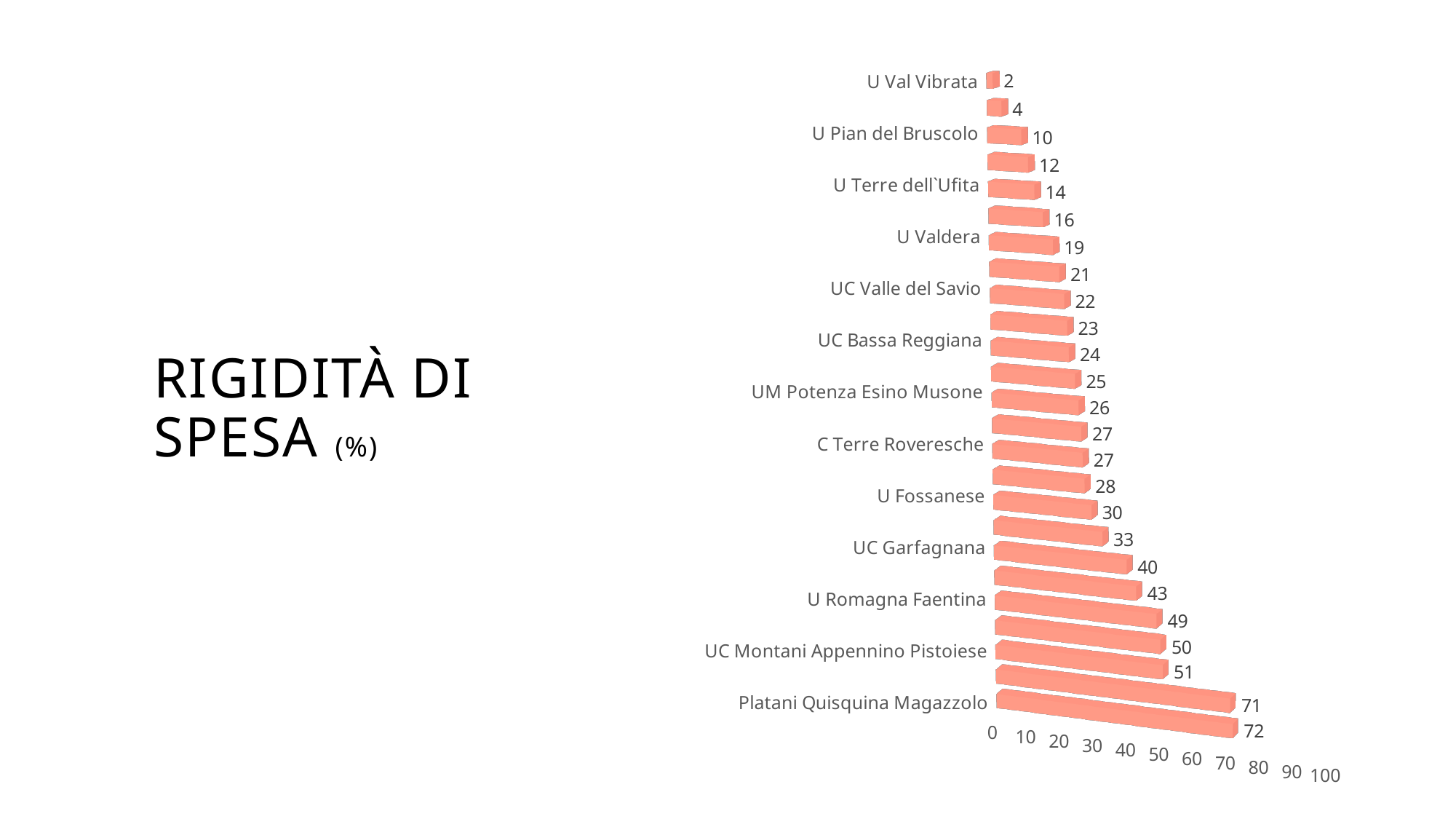
Which category has the lowest value? U Val Vibrata Do the values increase or decrease going from the top bar to the bottom bar? increase How many bars are plotted in the chart? 25 What is the highest value shown in the chart? 72 What is the difference between the highest value (72) and the lowest value (2)? 70 Is the value for UC Garfagnana greater or less than 50? less Is the value for Platani Quisquina Magazzolo greater or less than 60? greater Which is larger, the value for Platani Quisquina Magazzolo or the value for U Val Vibrata? Platani Quisquina Magazzolo What is the value for U Val Vibrata? 2 What is the title of the chart? RIGIDITÀ DI SPESA (%) What is the value for C Terre Roveresche? 27 What kind of chart is shown on the slide? bar chart